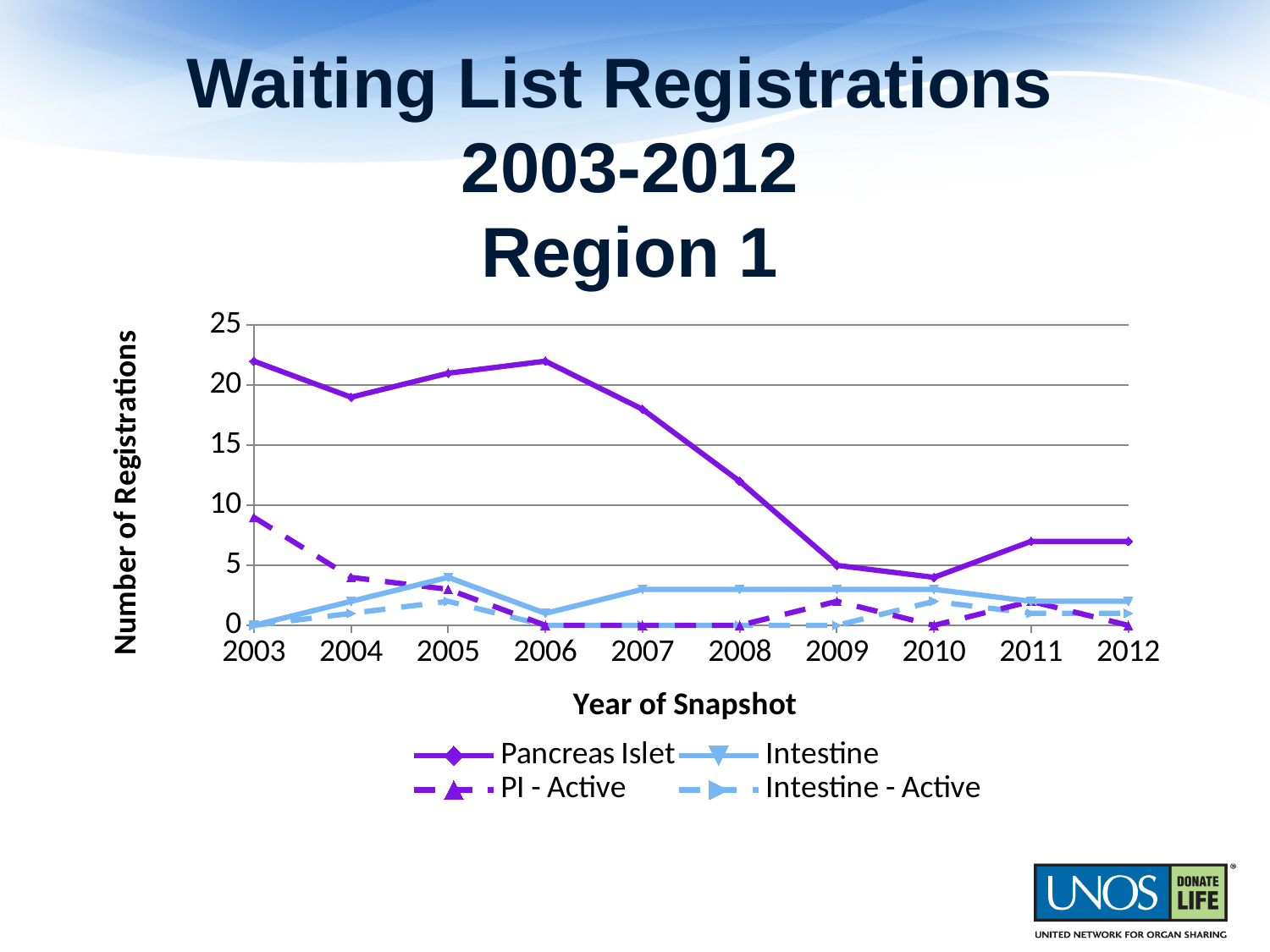
Which series has the highest value in 2003? Pancreas Islet What is the value for PI - Active in 2007? 0 What is the value for Intestine - Active in 2003? 0 Does the Pancreas Islet line rise or fall from 2006 to 2009? fall Is the value for Pancreas Islet in 2008 greater or less than 15? less Is the value for Pancreas Islet in 2011 greater or less than 10? less How many years are plotted along the x axis? 10 Is the value for PI - Active in 2003 greater or less than 5? greater What kind of chart is shown on the slide? line chart How many series does the legend list? 4 What is the title of the x axis? Year of Snapshot